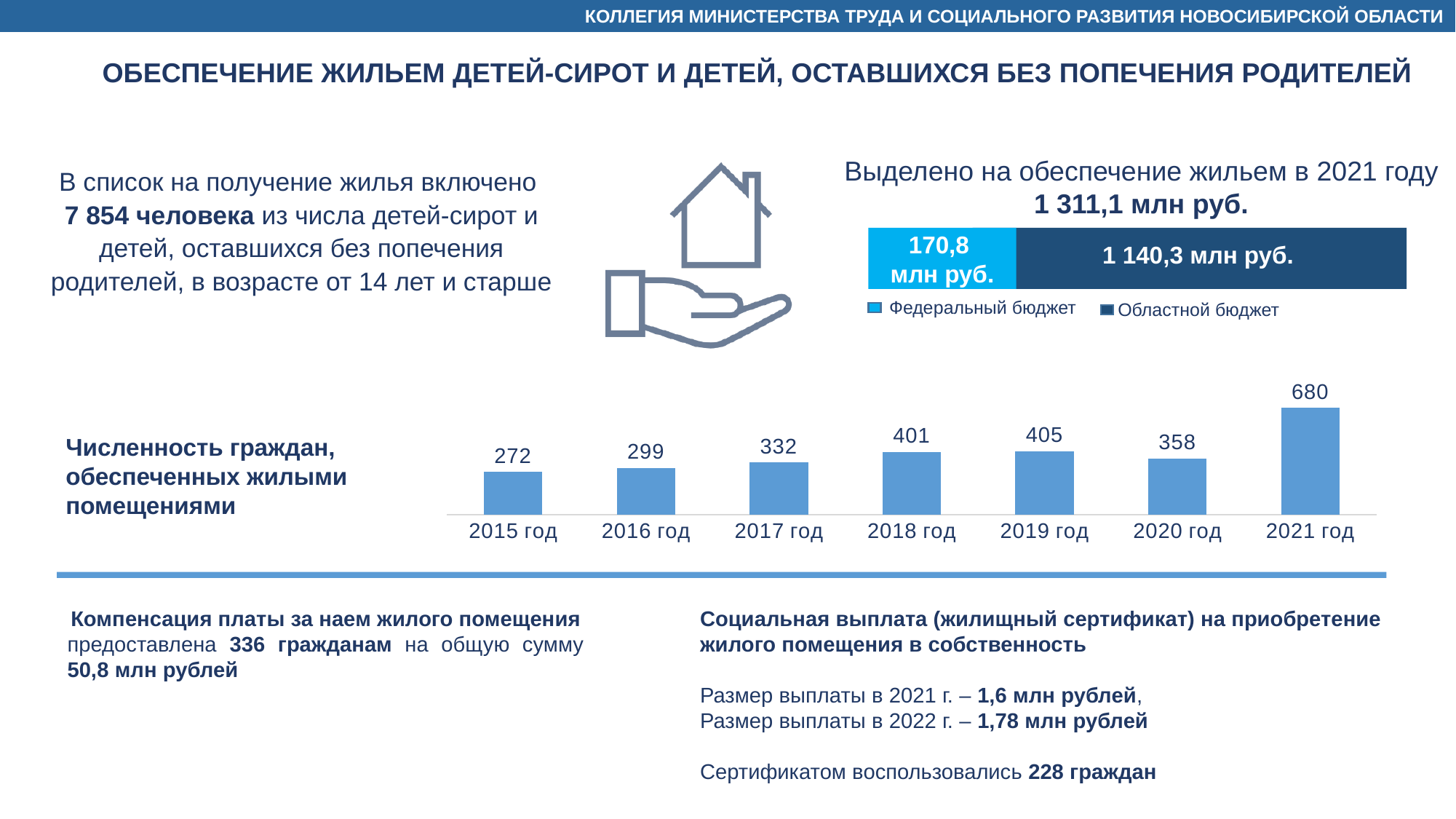
On the chart 'Численность граждан, обеспеченных жилыми помещениями', which year has the highest value? 2021 год On the chart 'Численность граждан, обеспеченных жилыми помещениями', what is the value for 2015 год? 272 What kind of chart is 'Численность граждан, обеспеченных жилыми помещениями'? bar chart On the chart 'Численность граждан, обеспеченных жилыми помещениями', do the values rise or fall from 2015 год to 2019 год? rise On the chart 'Численность граждан, обеспеченных жилыми помещениями', what is the difference between the values for 2021 год and 2020 год? 322 On the chart 'Численность граждан, обеспеченных жилыми помещениями', what is the value for 2021 год? 680 How many years are shown on the chart 'Численность граждан, обеспеченных жилыми помещениями'? 7 On the chart 'Выделено на обеспечение жильем в 2021 году', what is the value for Федеральный бюджет? 170,8 млн руб. On the chart 'Численность граждан, обеспеченных жилыми помещениями', which year has the lowest value? 2015 год On the chart 'Численность граждан, обеспеченных жилыми помещениями', which is larger: the value for 2017 год or for 2020 год? 2020 год How many series does the legend list on the chart 'Выделено на обеспечение жильем в 2021 году'? 2 On the chart 'Выделено на обеспечение жильем в 2021 году', what is the total of the stacked bar? 1 311,1 млн руб.